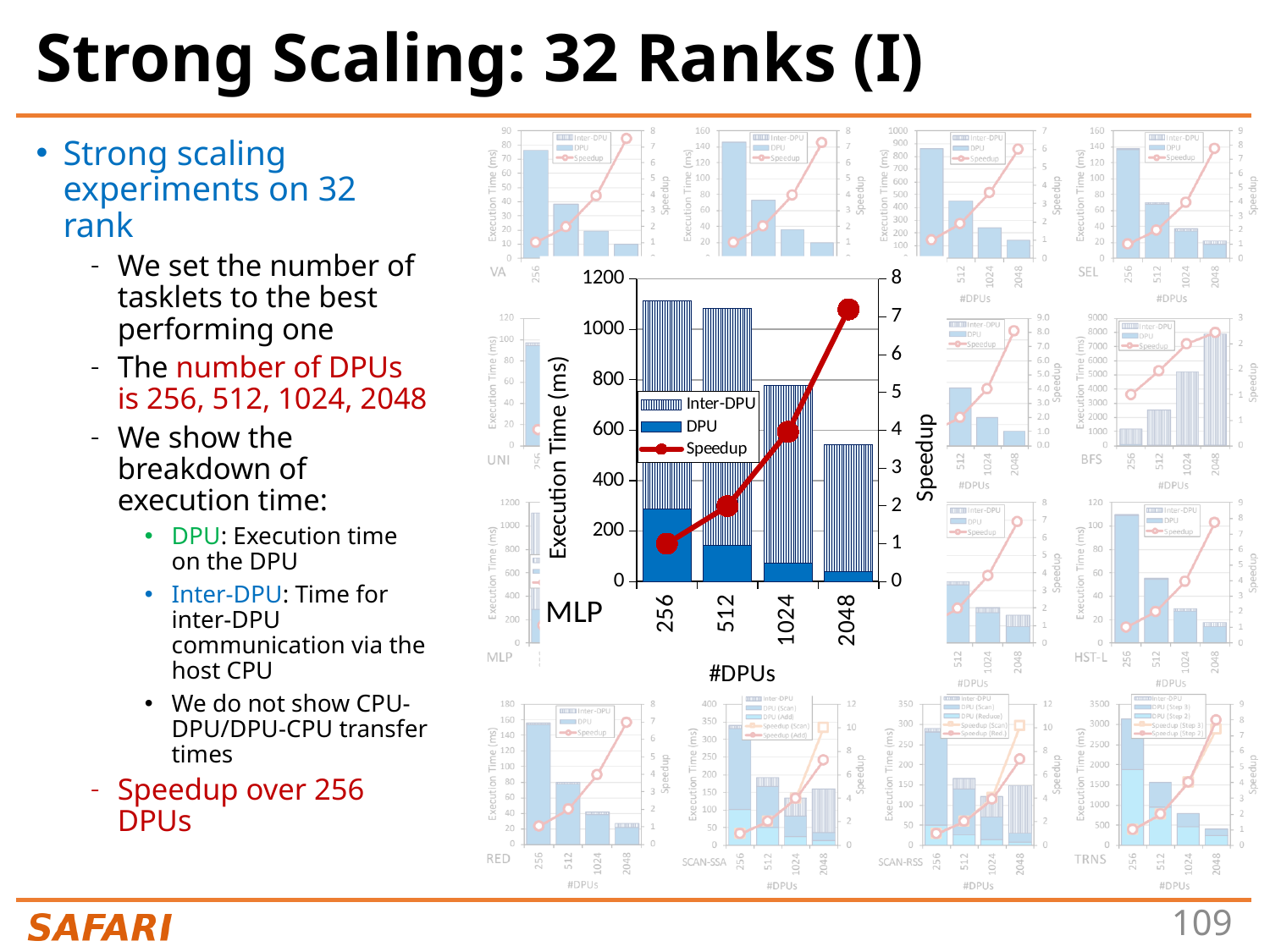
On the enlarged MLP chart, does the total execution time rise or fall as the number of DPUs increases? fall On the enlarged MLP chart, how many series does the legend list? 3 On the enlarged MLP chart, is the total execution time for 2048 DPUs greater or less than 600 ms? less On the enlarged MLP chart, is the Speedup at 2048 DPUs greater or less than 6? greater On the enlarged MLP chart, which #DPUs category has the highest Speedup? 2048 On the enlarged MLP chart, what is the Speedup value at 256 DPUs? 1 On the enlarged MLP chart, which #DPUs category has the lowest total execution time? 2048 On the enlarged MLP chart, which #DPUs category has the highest total execution time? 256 On the enlarged MLP chart, is the total execution time for 256 DPUs greater or less than 1000 ms? greater On the enlarged MLP chart, what are the three legend entries? Inter-DPU, DPU, Speedup On the enlarged MLP chart, what is the label of the x axis? #DPUs On the enlarged MLP chart, how many #DPUs categories are shown on the x axis? 4